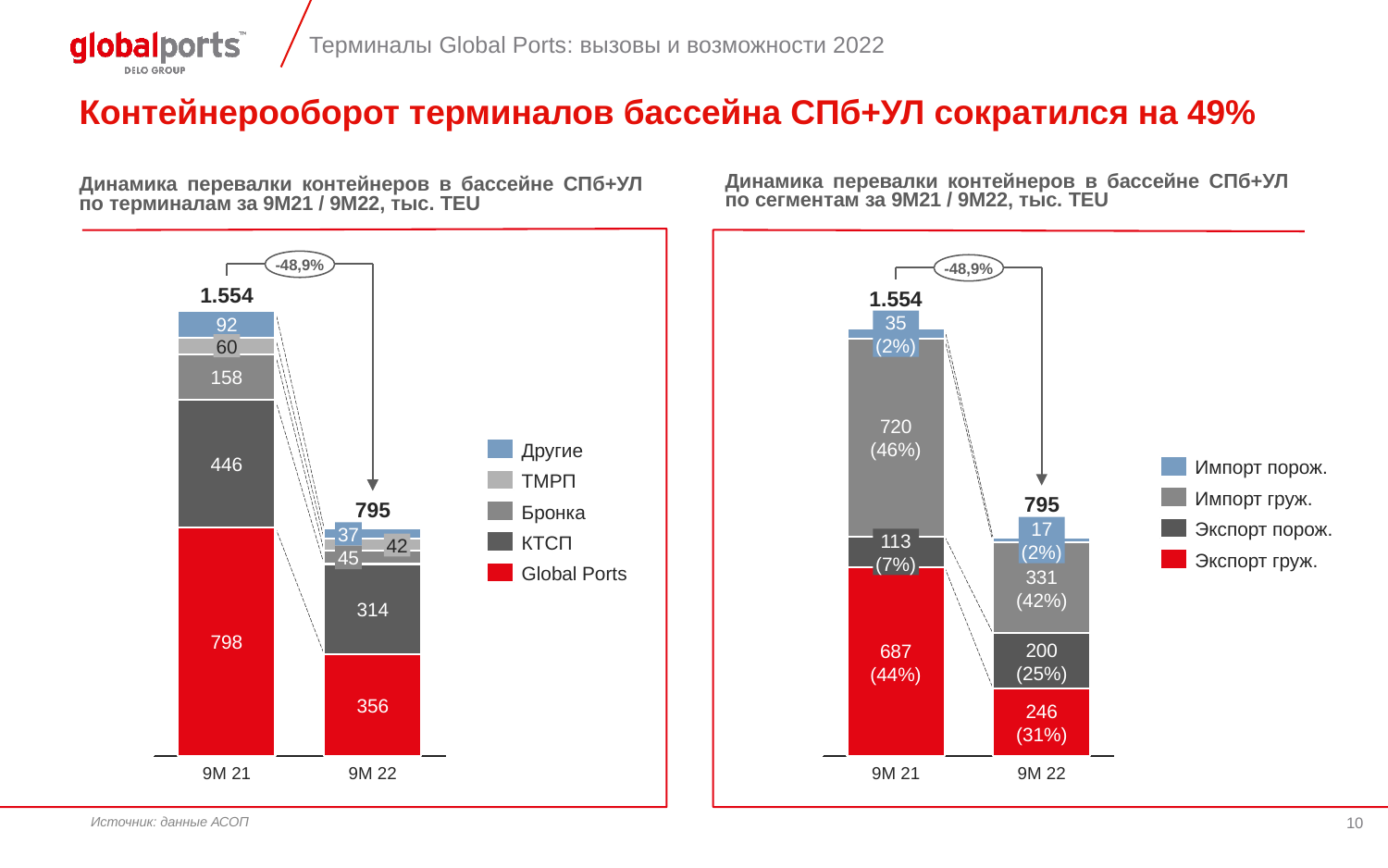
In the left chart (by terminals), what is the value for Global Ports in 9M 21? 798 In the left chart (by terminals), how many series does the legend list? 5 In the left chart (by terminals), which terminal has the smallest value in 9M 22? Другие In the right chart (by segments), what share of the 9M 22 total does Экспорт груж. represent? 31% In the right chart (by segments), which segment has the largest value in 9M 22? Импорт груж. In the right chart (by segments), is the value for Экспорт порож. in 9M 22 larger or smaller than in 9M 21? larger In the left chart (by terminals), which terminal has the largest value in 9M 21? Global Ports In the right chart (by segments), what is the value for Импорт груж. in 9M 21? 720 In the left chart (by terminals), what is the difference between the Global Ports values for 9M 21 and 9M 22? 442 In the left chart (by terminals), what is the value for КТСП in 9M 22? 314 What type of chart is shown on the right side of the slide? Stacked bar chart In the left chart (by terminals), what is the total of the 9M 22 stacked bar? 795